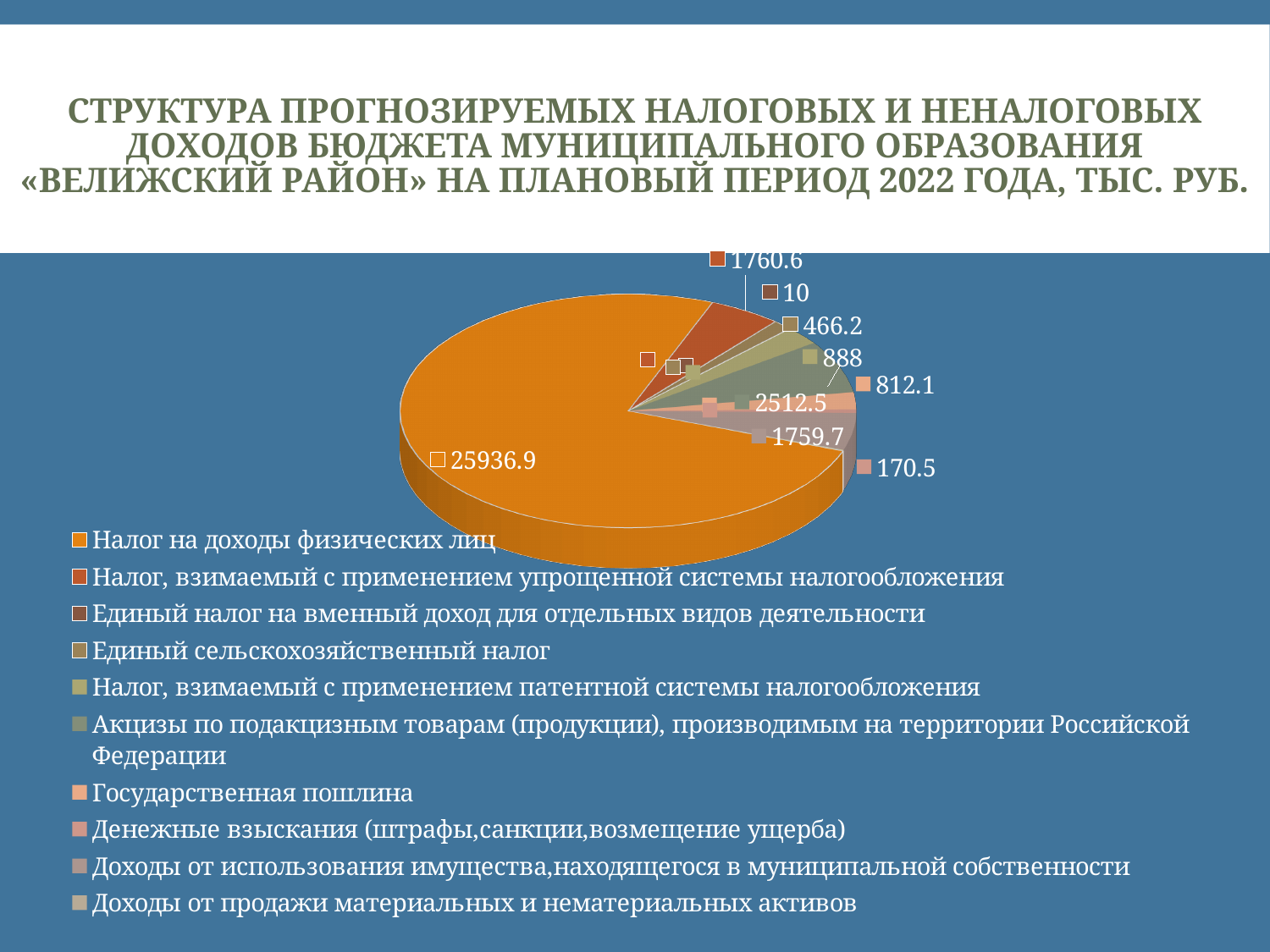
What is the smallest value printed as a data label on the pie chart? 10 What value is shown for Единый налог на вмененный доход для отдельных видов деятельности? 10 Which category has the largest slice in the pie chart? Налог на доходы физических лиц How many categories does the legend of the pie chart list? 10 What value is shown for Акцизы по подакцизным товарам (продукции), производимым на территории Российской Федерации? 2512.5 Which is larger: the value for Налог, взимаемый с применением патентной системы налогообложения (888) or the value for Государственная пошлина (812.1)? Налог, взимаемый с применением патентной системы налогообложения What kind of chart is shown on the slide? pie chart What is the difference between the value for Налог на доходы физических лиц (25936.9) and the value for Акцизы (2512.5)? 23424.4 In what units are the values in the chart expressed, according to the slide title? тыс. руб. What value is shown for Налог, взимаемый с применением упрощенной системы налогообложения? 1760.6 What is the value shown for the largest slice of the pie chart? 25936.9 What value is shown for Государственная пошлина? 812.1